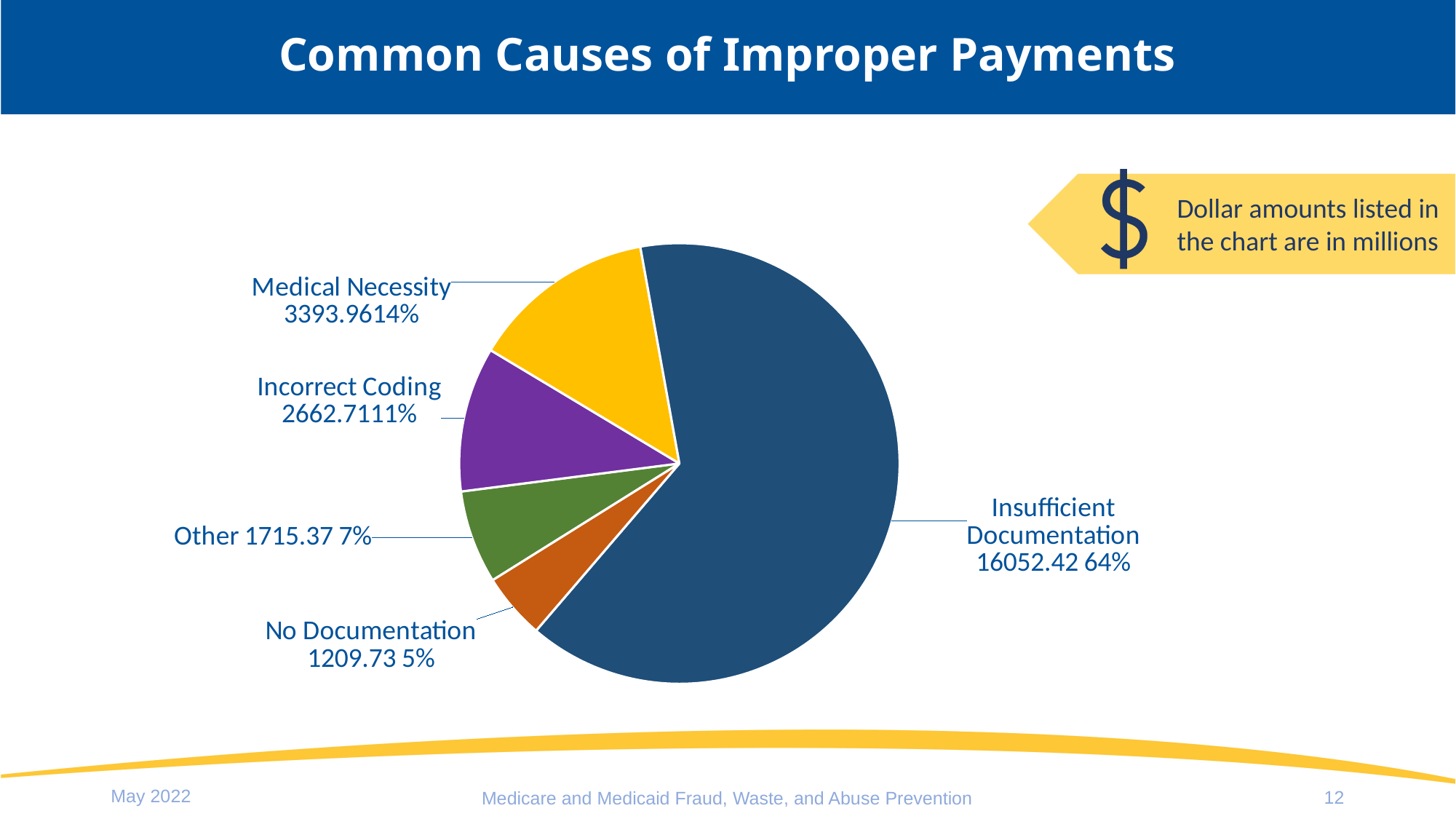
What is the title of the slide containing the pie chart? Common Causes of Improper Payments Which category has the largest slice of the pie chart? Insufficient Documentation How many categories (slices) does the pie chart show? 5 What kind of chart is shown on the slide? pie chart What dollar amount is shown for No Documentation? 1209.73 What share of the pie does Insufficient Documentation represent? 64% Which is larger, the value for Other or the value for No Documentation? Other What dollar amount is shown for Insufficient Documentation? 16052.42 What dollar amount is shown for Other? 1715.37 What is the difference between the values for Other and No Documentation? 505.64 What share of the pie does Other represent? 7% Which category has the smallest slice of the pie chart? No Documentation